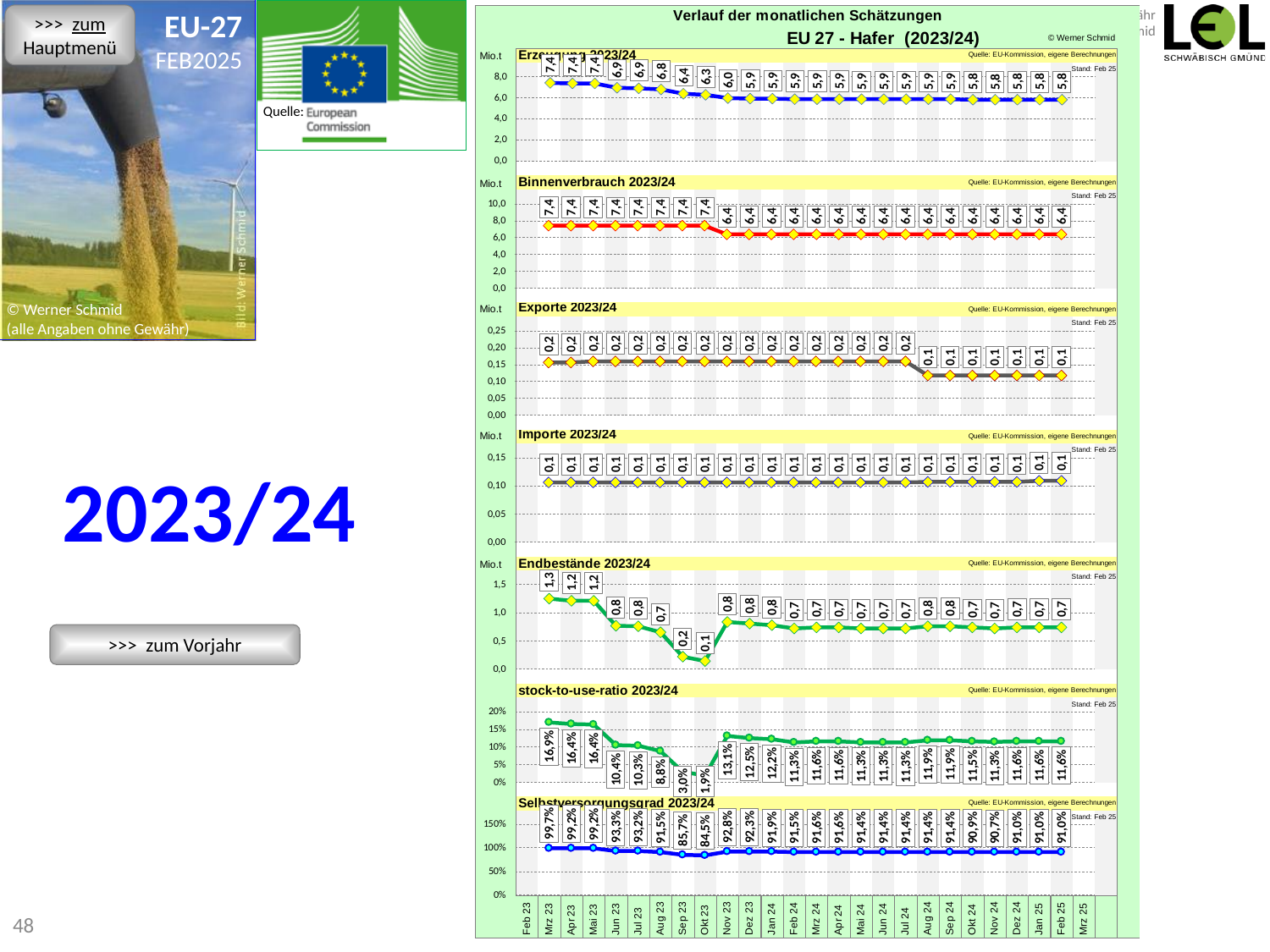
How many separate chart panels are shown under 'Verlauf der monatlichen Schätzungen EU 27 - Hafer (2023/24)'? 7 In the 'Endbestände 2023/24' chart, what is the highest value shown? 1,3 In the 'Selbstversorgungsgrad 2023/24' chart, what is the value of the last data point (Feb 25)? 91,0% In the 'Erzeugung 2023/24' chart, do the values rise or fall from left to right? fall What kind of chart is used for the 'Erzeugung 2023/24' panel? line chart In the 'stock-to-use-ratio 2023/24' chart, what is the lowest value shown? 1,9% Which is larger at Feb 25: the 'Erzeugung 2023/24' value or the 'Binnenverbrauch 2023/24' value? Binnenverbrauch 2023/24 In the 'Binnenverbrauch 2023/24' chart, what is the value of the last data point (Feb 25)? 6,4 In the 'Erzeugung 2023/24' chart, what is the value of the last data point (Feb 25)? 5,8 In the 'Erzeugung 2023/24' chart, what is the difference between the first value (7,4) and the last value (5,8)? 1,6 In the 'Erzeugung 2023/24' chart, what is the value of the first data point? 7,4 In the 'Endbestände 2023/24' chart, what is the lowest value shown? 0,1